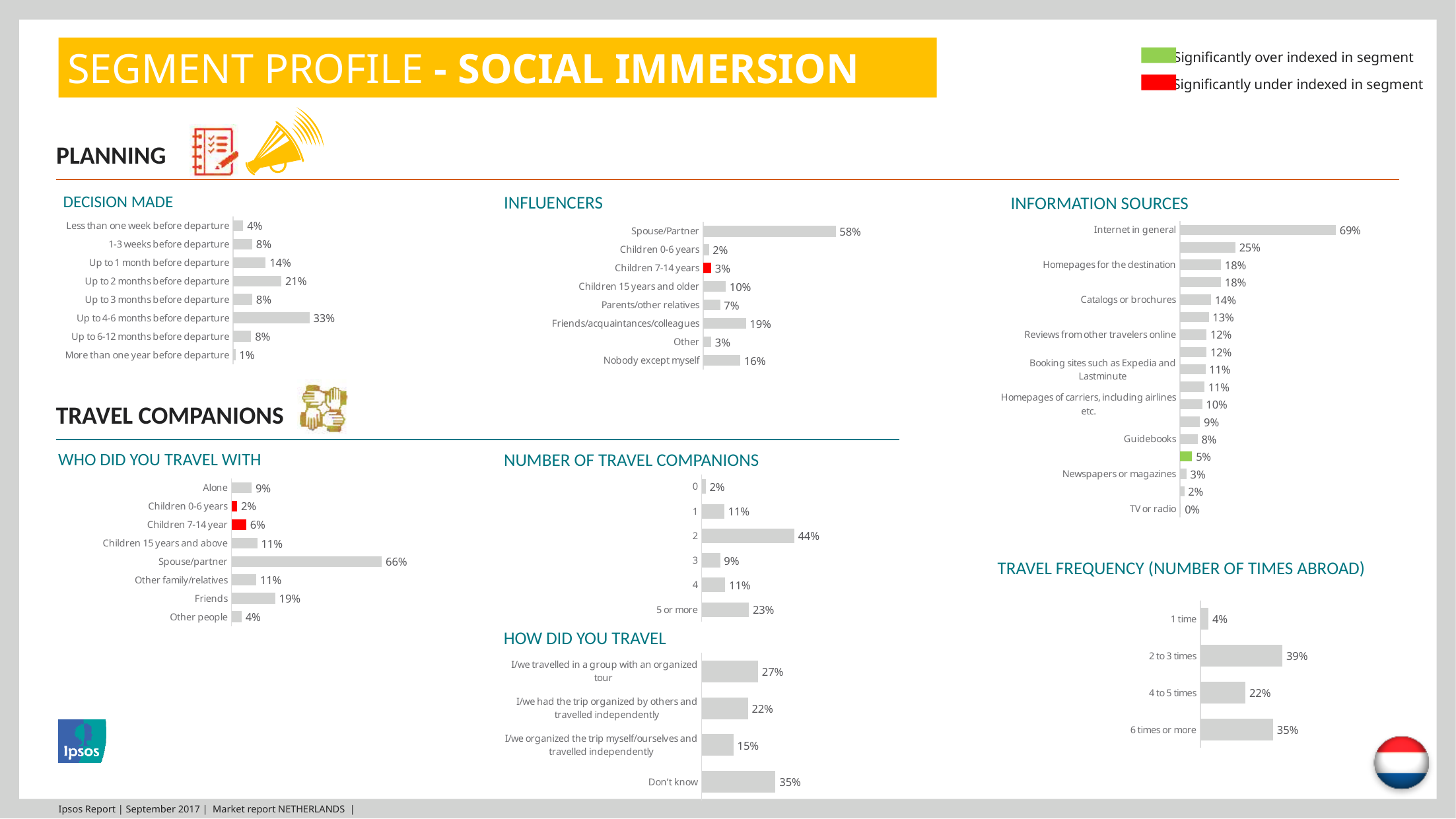
What kind of chart is the TRAVEL FREQUENCY (NUMBER OF TIMES ABROAD) chart? Bar chart In the INFLUENCERS chart, which category has the highest value? Spouse/Partner How many categories does the WHO DID YOU TRAVEL WITH chart show? 8 In the HOW DID YOU TRAVEL chart, what is the value for I/we organized the trip myself/ourselves and travelled independently? 15% In the INFORMATION SOURCES chart, what is the value for Internet in general? 69% In the DECISION MADE chart, which category has the lowest value? More than one year before departure In the INFORMATION SOURCES chart, which category has the lowest value? TV or radio In the INFLUENCERS chart, what is the difference between Spouse/Partner and Nobody except myself? 42% In the WHO DID YOU TRAVEL WITH chart, which is larger, Friends or Alone? Friends In the NUMBER OF TRAVEL COMPANIONS chart, what is the value for 2? 44% In the DECISION MADE chart, what is the value for Up to 4-6 months before departure? 33% In the INFLUENCERS chart, what is the value for Friends/acquaintances/colleagues? 19%